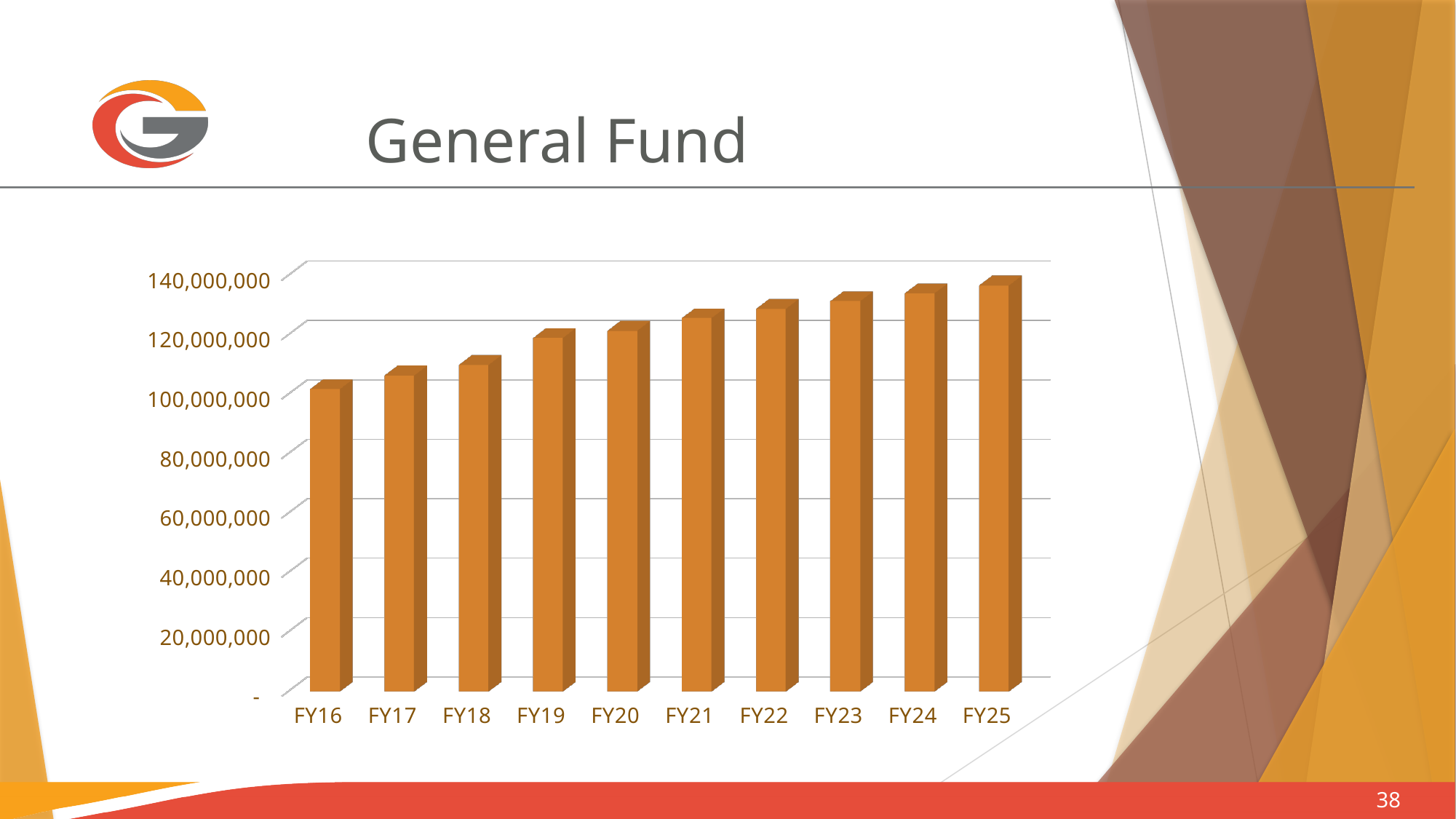
What kind of chart is shown on the slide? bar chart Is the value for FY16 greater or less than 120,000,000? less How many fiscal years are plotted on the x axis? 10 Is the value for FY19 greater or less than 100,000,000? greater Is the value for FY21 greater or less than 140,000,000? less What is the title of the slide containing the chart? General Fund Which is larger, the value for FY16 or the value for FY25? FY25 Which fiscal year has the highest bar? FY25 Which is larger, the value for FY18 or the value for FY23? FY23 Which fiscal year has the lowest bar? FY16 Do the values rise or fall from FY16 to FY25? rise